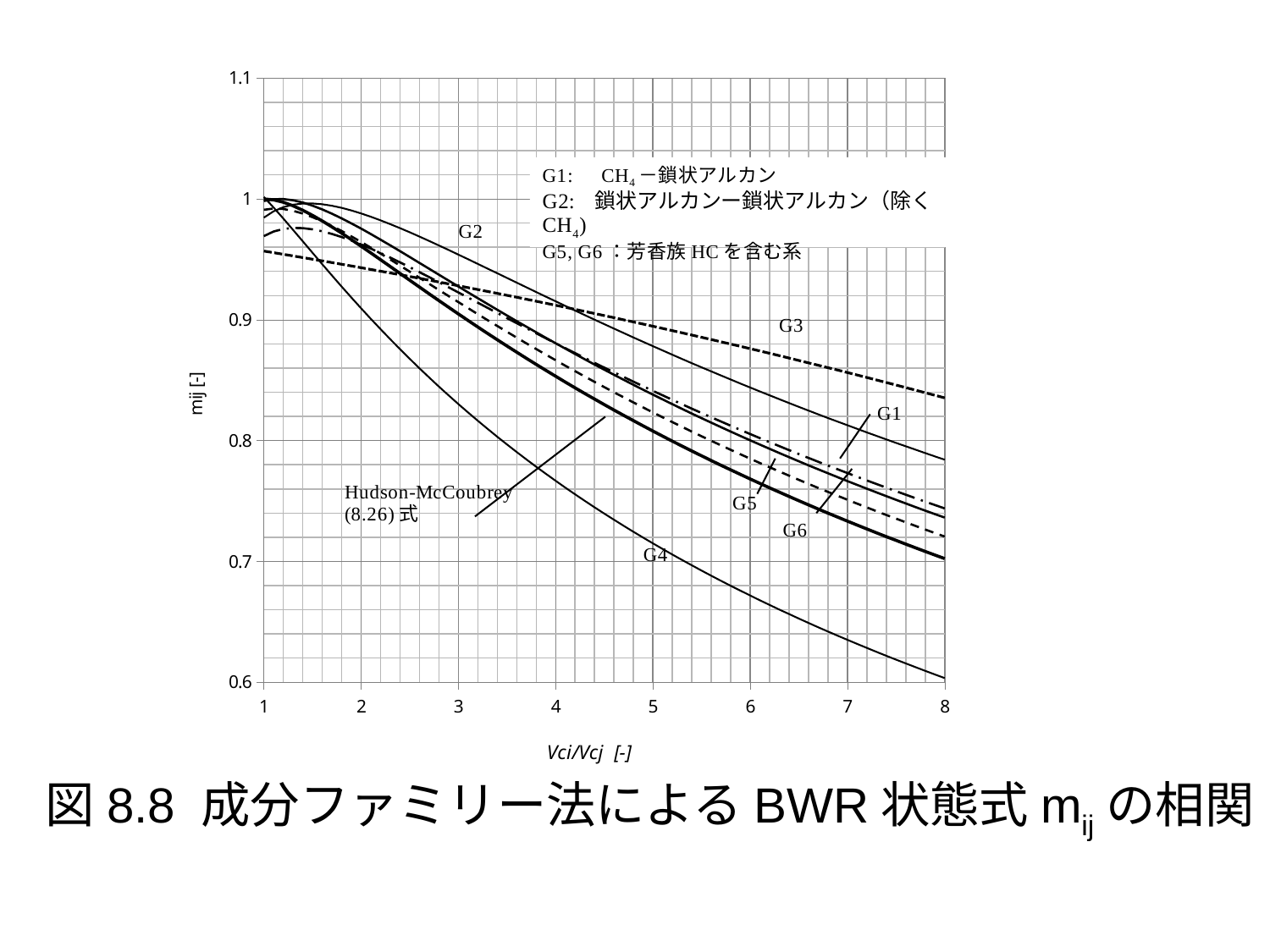
What kind of chart is shown on the slide? line chart Do the curves generally rise or fall as Vci/Vcj increases from 1 to 8? fall Which curve has the lowest mij value at Vci/Vcj = 8? G4 At Vci/Vcj = 8, which curve has the larger mij value, G3 or G4? G3 What is the label of the y axis? mij [-] At Vci/Vcj = 1, is the mij value of the G3 curve greater or less than 1? less What is the label of the x axis? Vci/Vcj [-] At Vci/Vcj = 2, which curve has the larger mij value, G2 or G4? G2 At Vci/Vcj = 6, is the mij value of the G4 curve greater or less than 0.7? less How many labelled curves are plotted on the chart? 7 At Vci/Vcj = 8, is the mij value of the G3 curve greater or less than 0.8? greater Which curve has the highest mij value at Vci/Vcj = 8? G3